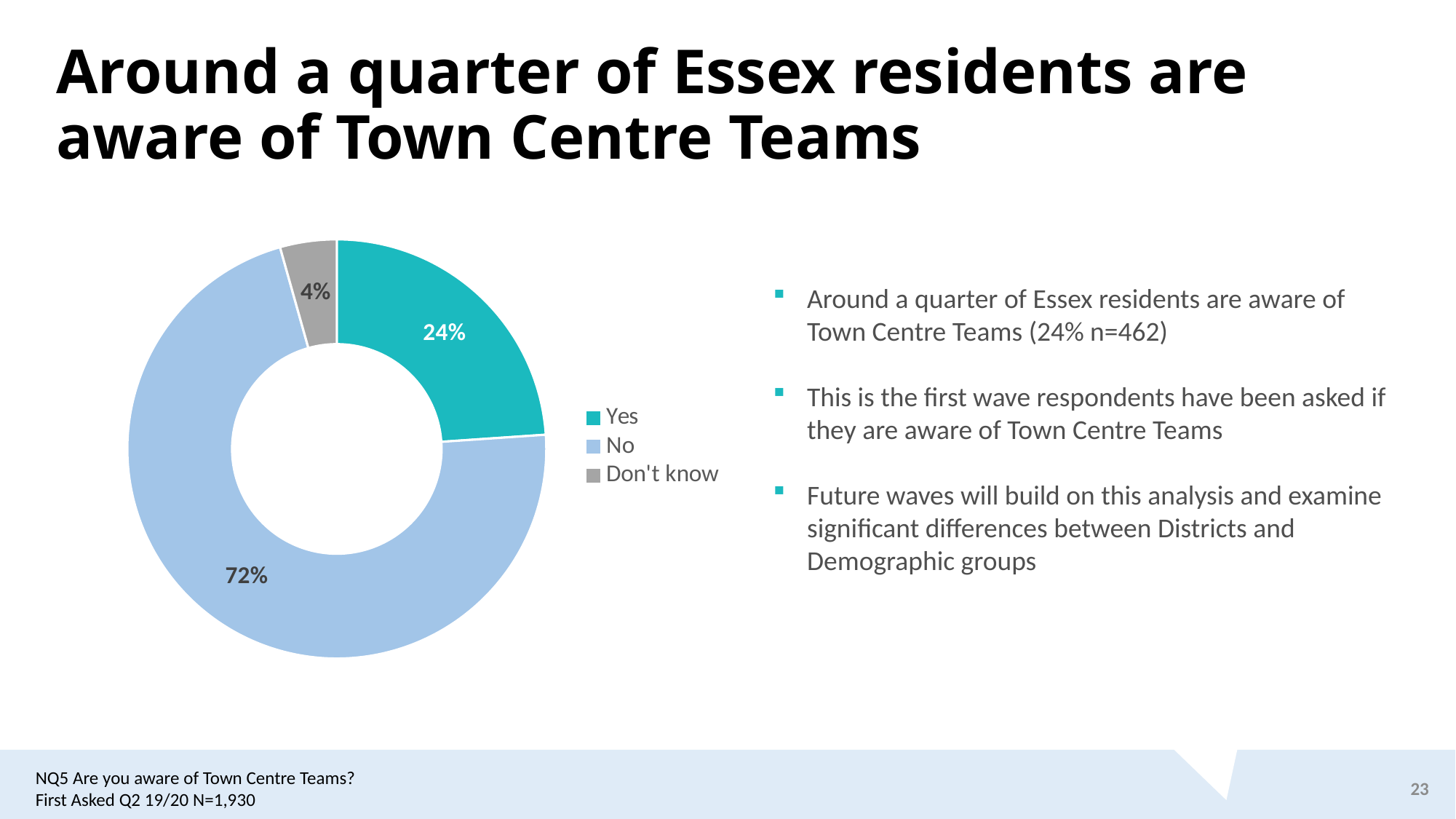
What is the difference in percentage points between the 'No' and 'Yes' shares? 48 What kind of chart is shown on the slide? Doughnut (pie) chart Which response category has the smallest share of the chart? Don't know What colour is the 'Yes' slice in the chart? Teal What percentage of respondents answered 'No'? 72% Which is larger, the share for 'Yes' or the share for 'Don't know'? Yes What percentage of respondents answered 'Don't know'? 4% What percentage of respondents answered 'Yes' to being aware of Town Centre Teams? 24% What survey question does the chart relate to, as shown at the bottom of the slide? NQ5 Are you aware of Town Centre Teams? What share of the chart does the 'No' slice represent? 72% How many response categories are shown in the chart? 3 Which response category has the largest share of the chart? No